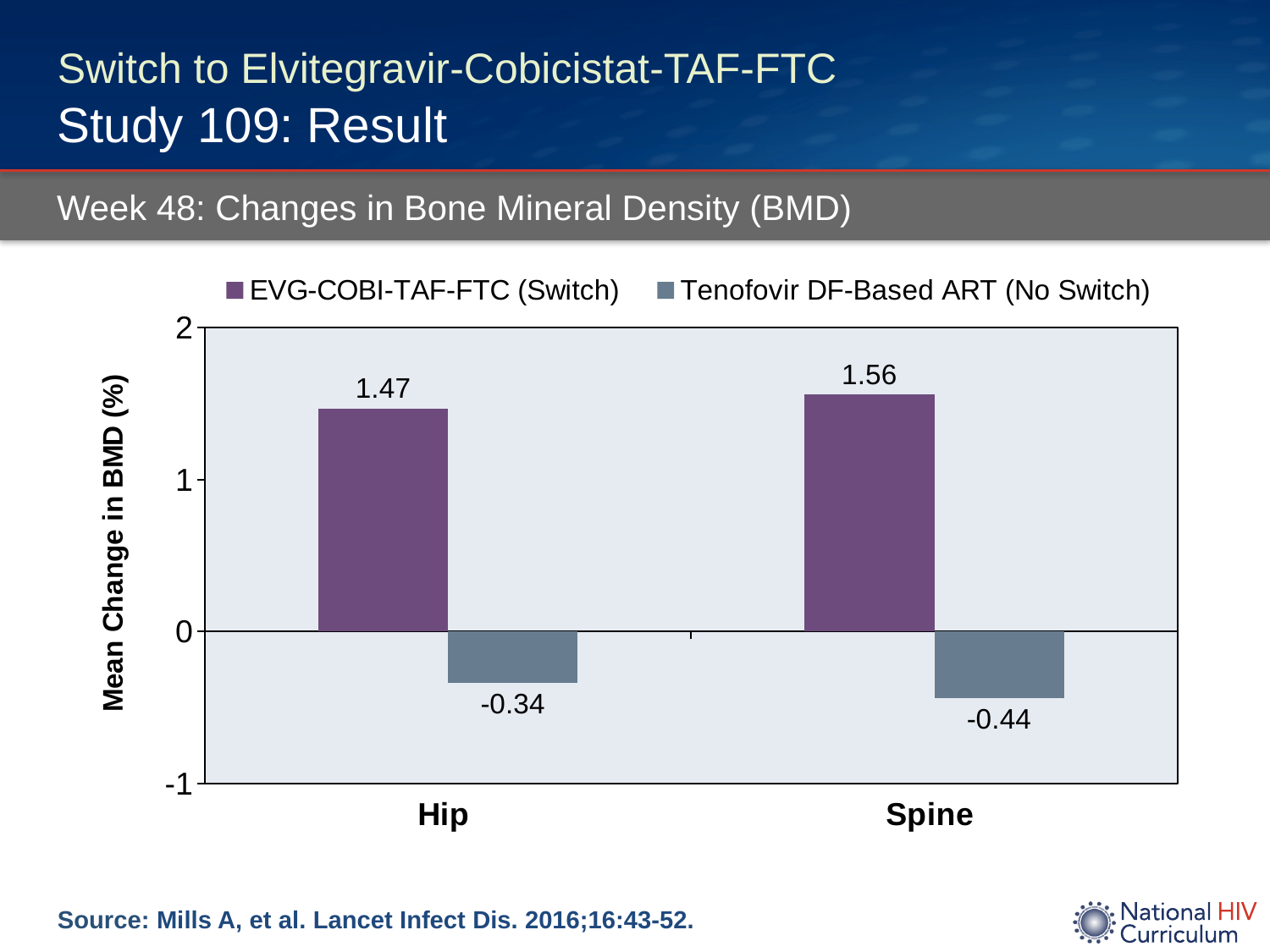
What kind of chart is shown on the slide? Bar chart What is the difference between the Switch and No Switch groups' mean change in BMD at the Hip? 1.81 What is the mean change in BMD for the Tenofovir DF-Based ART (No Switch) group at the Hip? -0.34 How many categories are shown on the x axis? 2 What is the mean change in BMD for the Tenofovir DF-Based ART (No Switch) group at the Spine? -0.44 Which group has the larger mean change in BMD at the Spine, EVG-COBI-TAF-FTC (Switch) or Tenofovir DF-Based ART (No Switch)? EVG-COBI-TAF-FTC (Switch) What is the mean change in BMD for the EVG-COBI-TAF-FTC (Switch) group at the Spine? 1.56 What is the difference between the Switch and No Switch groups' mean change in BMD at the Spine? 2.00 What is the mean change in BMD for the EVG-COBI-TAF-FTC (Switch) group at the Hip? 1.47 Which site shows the lowest mean change in BMD for the Tenofovir DF-Based ART (No Switch) group? Spine How many series does the legend list? 2 Which site shows the highest mean change in BMD for the EVG-COBI-TAF-FTC (Switch) group? Spine